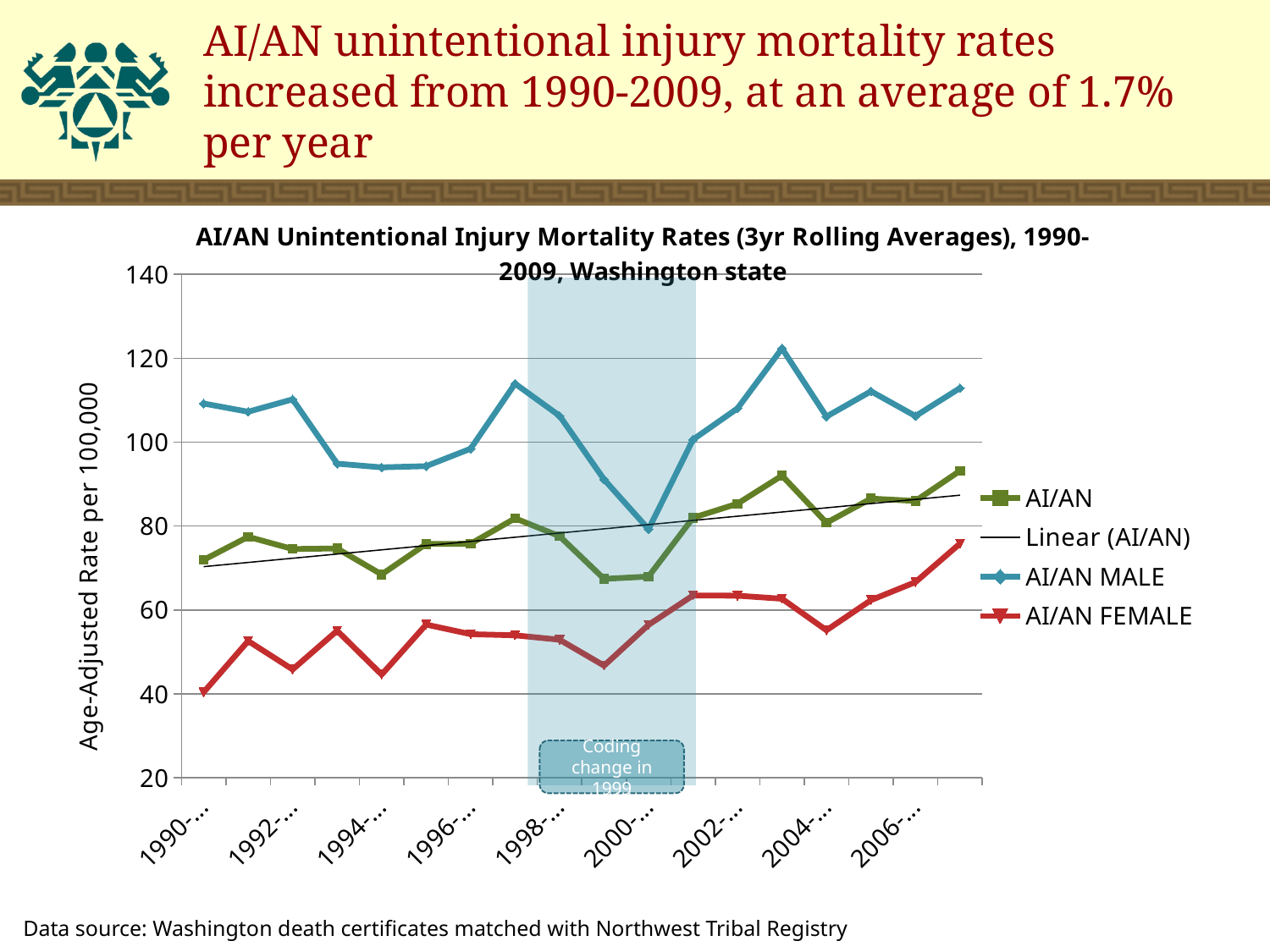
What event does the shaded region on the chart mark? Coding change in 1999 Is the AI/AN MALE value at the first point (1990-…) greater or less than 100? greater Does the Linear (AI/AN) trendline rise or fall from left to right? rise How many entries does the chart legend list? 4 What kind of chart is shown on the slide? line chart Is the AI/AN MALE value at the 2000-… point greater or less than 100? less What is the label on the vertical axis of the chart? Age-Adjusted Rate per 100,000 Is the AI/AN FEMALE value at the first point (1990-…) greater or less than 60? less At the 1990-… point, which is larger: the AI/AN MALE value or the AI/AN FEMALE value? AI/AN MALE Which series has the highest values throughout the chart? AI/AN MALE Which series has the lowest values throughout the chart? AI/AN FEMALE